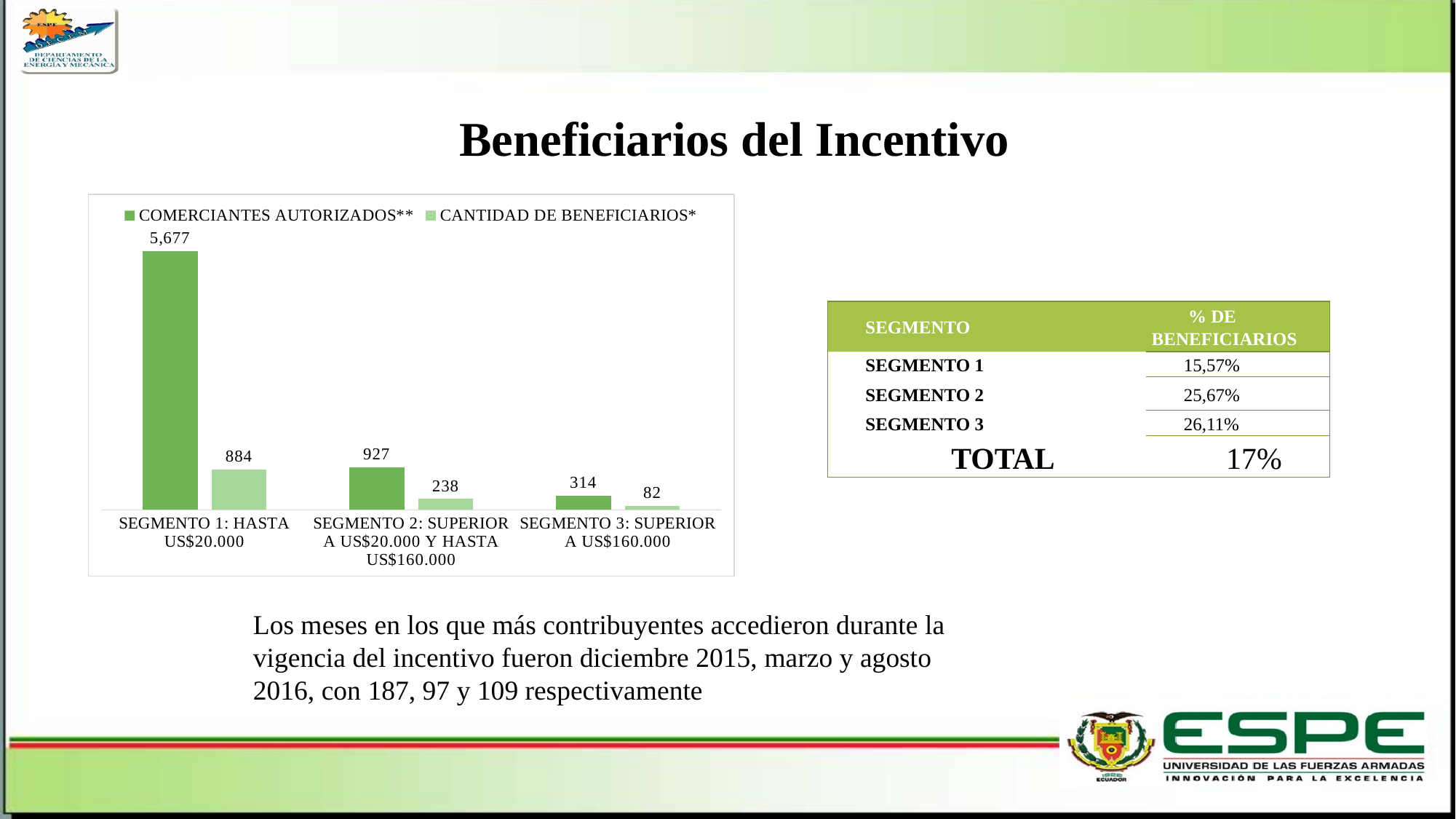
Which segment has the highest value for COMERCIANTES AUTORIZADOS**? SEGMENTO 1: HASTA US$20.000 Which is larger: CANTIDAD DE BENEFICIARIOS* for SEGMENTO 1 or COMERCIANTES AUTORIZADOS** for SEGMENTO 2? COMERCIANTES AUTORIZADOS** for SEGMENTO 2 What kind of chart is shown on the slide? Bar chart What is the value of CANTIDAD DE BENEFICIARIOS* for SEGMENTO 2: SUPERIOR A US$20.000 Y HASTA US$160.000? 238 What is the difference between COMERCIANTES AUTORIZADOS** and CANTIDAD DE BENEFICIARIOS* for SEGMENTO 2? 689 Which segment has the lowest value for CANTIDAD DE BENEFICIARIOS*? SEGMENTO 3: SUPERIOR A US$160.000 What is the value of COMERCIANTES AUTORIZADOS** for SEGMENTO 3: SUPERIOR A US$160.000? 314 How many segments are shown on the x axis of the chart? 3 How many series does the chart legend list? 2 Do the COMERCIANTES AUTORIZADOS** values rise or fall from SEGMENTO 1 to SEGMENTO 3? Fall What is the value of COMERCIANTES AUTORIZADOS** for SEGMENTO 1: HASTA US$20.000? 5,677 What is the value of CANTIDAD DE BENEFICIARIOS* for SEGMENTO 3: SUPERIOR A US$160.000? 82